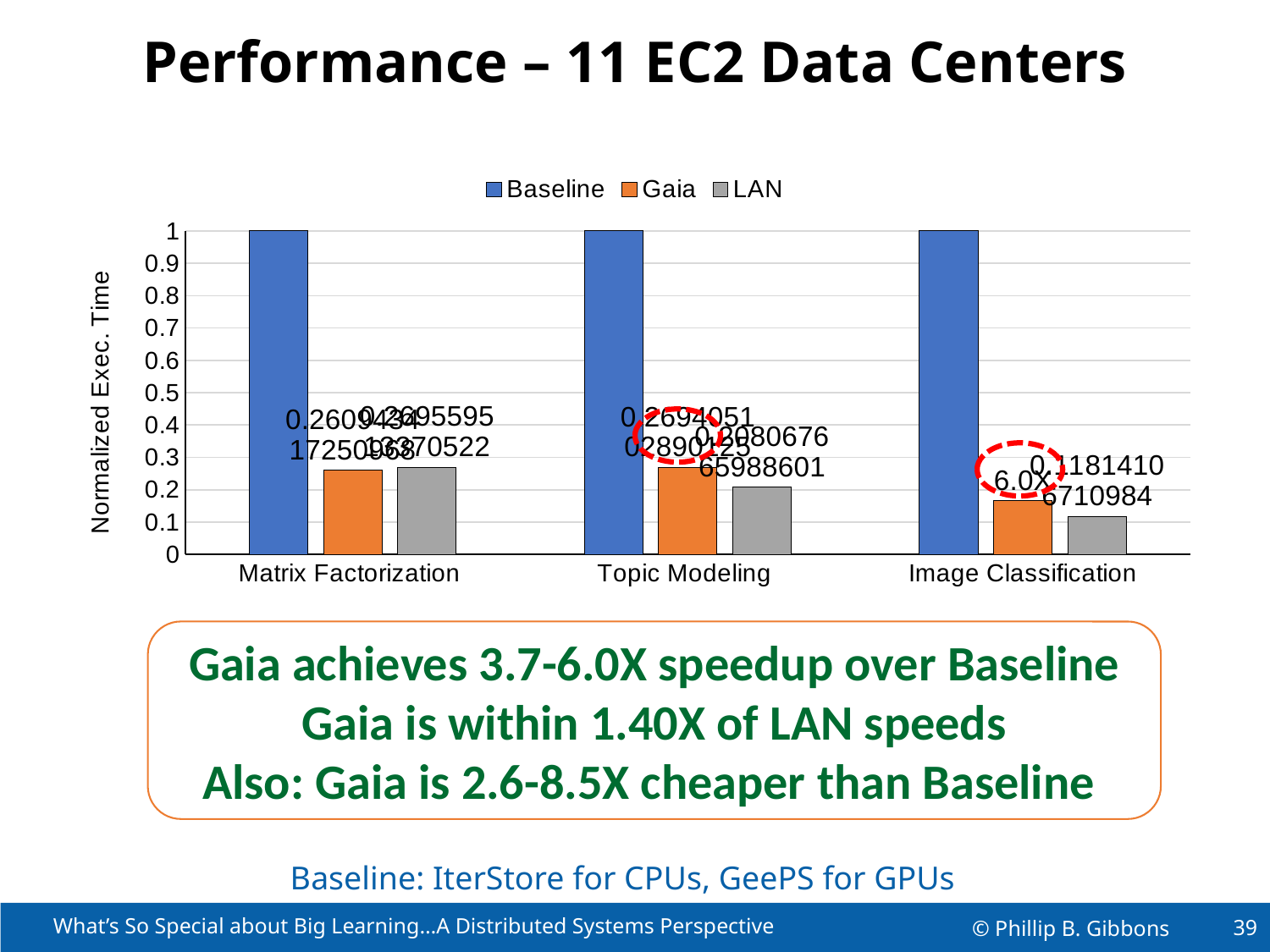
Is the Gaia value for Matrix Factorization greater or less than 0.5? less Which series has the lowest value for Image Classification? LAN Is the LAN value for Image Classification greater or less than 0.2? less Is the Gaia value for Topic Modeling greater or less than 0.2? greater Which series has the highest value for Matrix Factorization? Baseline What is the Baseline value for Image Classification? 1 How many categories are shown on the x axis? 3 What kind of chart is shown on the slide? bar chart For Image Classification, which is larger: the Gaia value or the LAN value? Gaia What is the Baseline value for Topic Modeling? 1 What is the title of the y axis? Normalized Exec. Time How many series does the legend list? 3